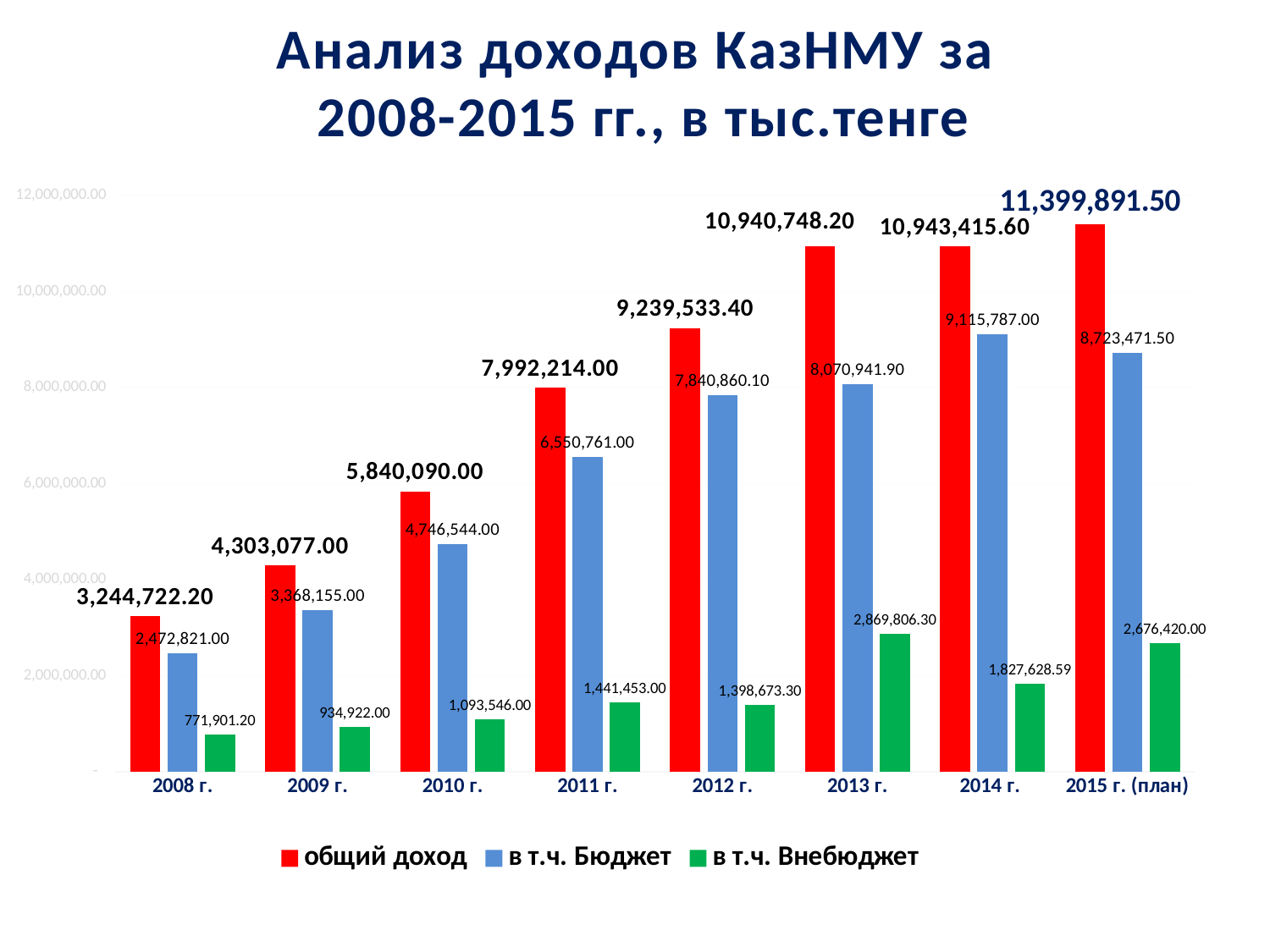
How many years are shown on the x axis? 8 How many series does the legend list? 3 Which year has the lowest в т.ч. Внебюджет value? 2008 г. What is the difference between общий доход and в т.ч. Бюджет for 2015 г. (план)? 2,676,420.00 What is the value of в т.ч. Бюджет for 2014 г.? 9,115,787.00 What is the difference in общий доход between 2013 г. and 2012 г.? 1,701,214.80 What is the value of в т.ч. Внебюджет for 2008 г.? 771,901.20 Which is larger, в т.ч. Бюджет for 2014 г. or for 2015 г. (план)? 2014 г. What is the value of общий доход for 2010 г.? 5,840,090.00 Which year has the highest в т.ч. Внебюджет value? 2013 г. Is the общий доход for 2011 г. greater or less than 6,000,000.00? greater Which year has the highest общий доход? 2015 г. (план)